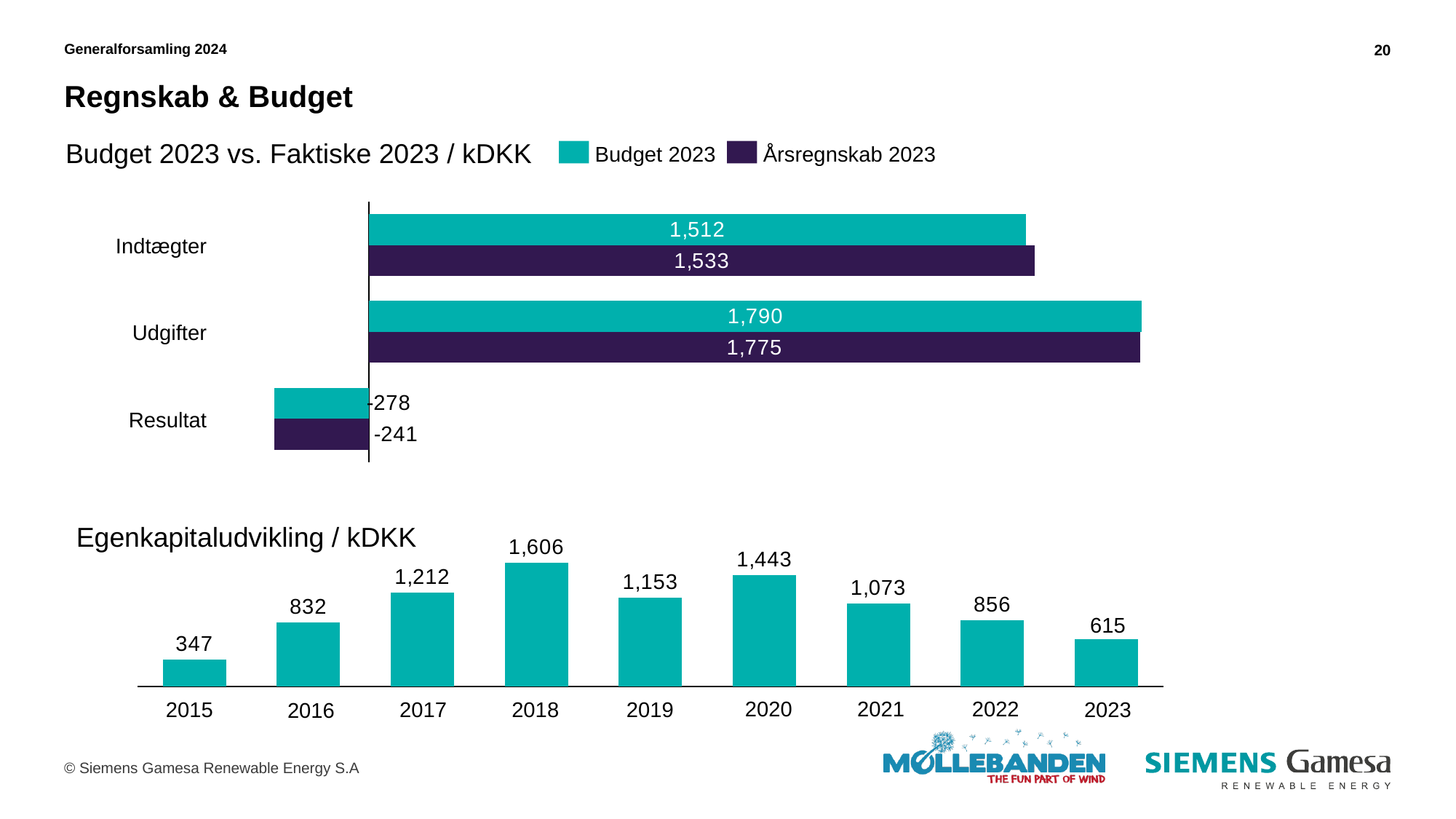
How many series does the legend of the 'Budget 2023 vs. Faktiske 2023 / kDKK' chart list? 2 In the 'Egenkapitaludvikling / kDKK' chart, what is the difference between the values for 2022 and 2023? 241 In the 'Budget 2023 vs. Faktiske 2023 / kDKK' chart, which is larger for Udgifter: Budget 2023 or Årsregnskab 2023? Budget 2023 What kind of chart is the 'Budget 2023 vs. Faktiske 2023 / kDKK' chart? Bar chart In the 'Egenkapitaludvikling / kDKK' chart, what is the value for 2020? 1,443 In the 'Budget 2023 vs. Faktiske 2023 / kDKK' chart, what is the Årsregnskab 2023 value for Udgifter? 1,775 How many years are shown in the 'Egenkapitaludvikling / kDKK' chart? 9 In the 'Egenkapitaludvikling / kDKK' chart, which year has the lowest value? 2015 In the 'Budget 2023 vs. Faktiske 2023 / kDKK' chart, what is the difference between the Budget 2023 and Årsregnskab 2023 values for Indtægter? 21 In the 'Budget 2023 vs. Faktiske 2023 / kDKK' chart, what is the Årsregnskab 2023 value for Resultat? -241 In the 'Budget 2023 vs. Faktiske 2023 / kDKK' chart, what is the Budget 2023 value for Indtægter? 1,512 In the 'Egenkapitaludvikling / kDKK' chart, which year has the highest value? 2018